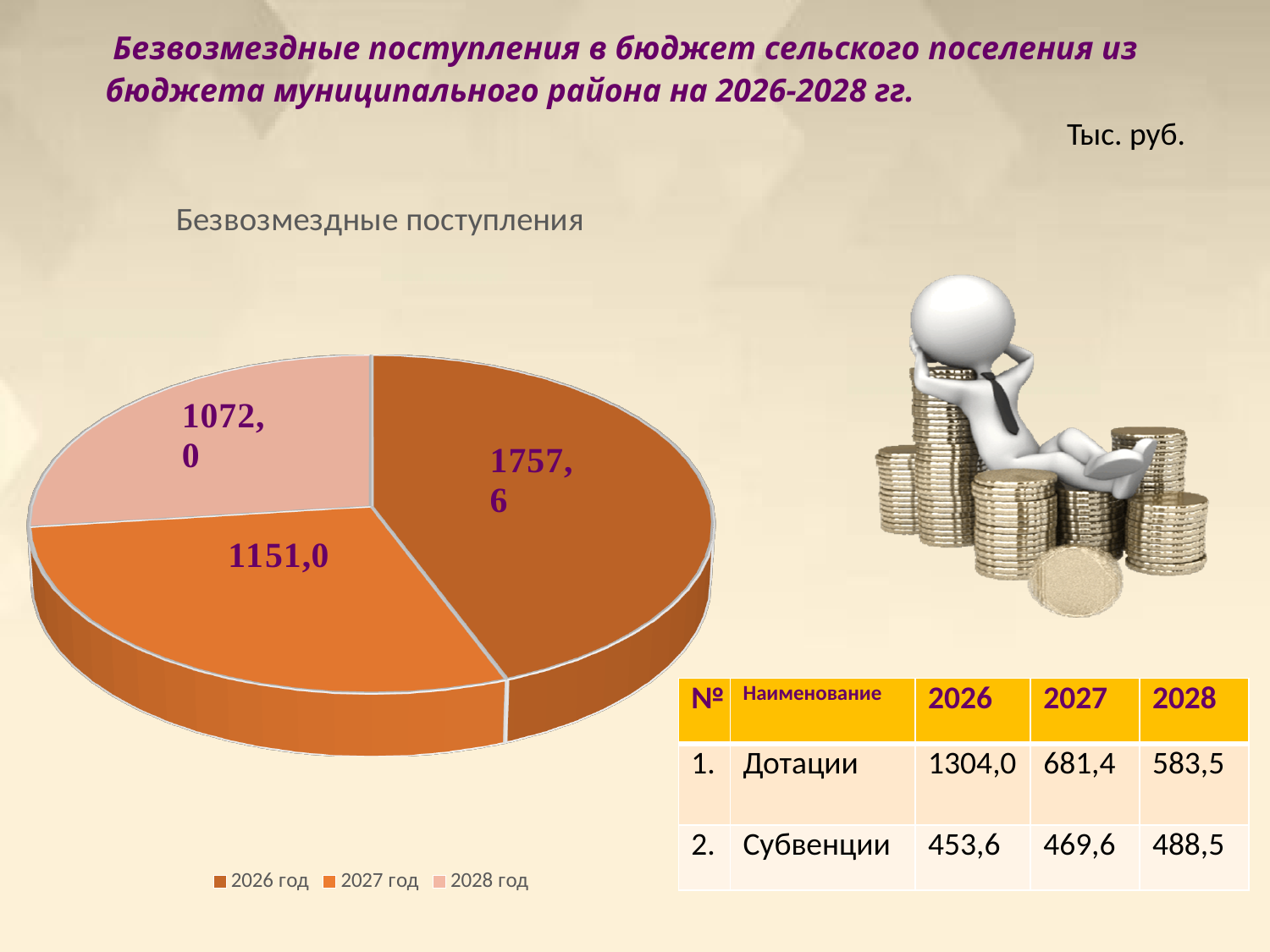
What is the difference between the values for 2027 год and 2028 год in the pie chart? 79,0 What is the value for 2028 год in the pie chart? 1072,0 Which year has the smallest slice in the pie chart? 2028 год Which year has the largest slice in the pie chart? 2026 год Which is larger in the pie chart, the value for 2027 год or 2028 год? 2027 год How many entries does the legend of the pie chart list? 3 How many slices does the pie chart have? 3 What is the value for 2027 год in the pie chart? 1151,0 What is the value for 2026 год in the pie chart? 1757,6 What is the difference between the values for 2026 год and 2027 год in the pie chart? 606,6 What kind of chart is shown on the slide? Pie chart What is the title of the chart on the slide? Безвозмездные поступления